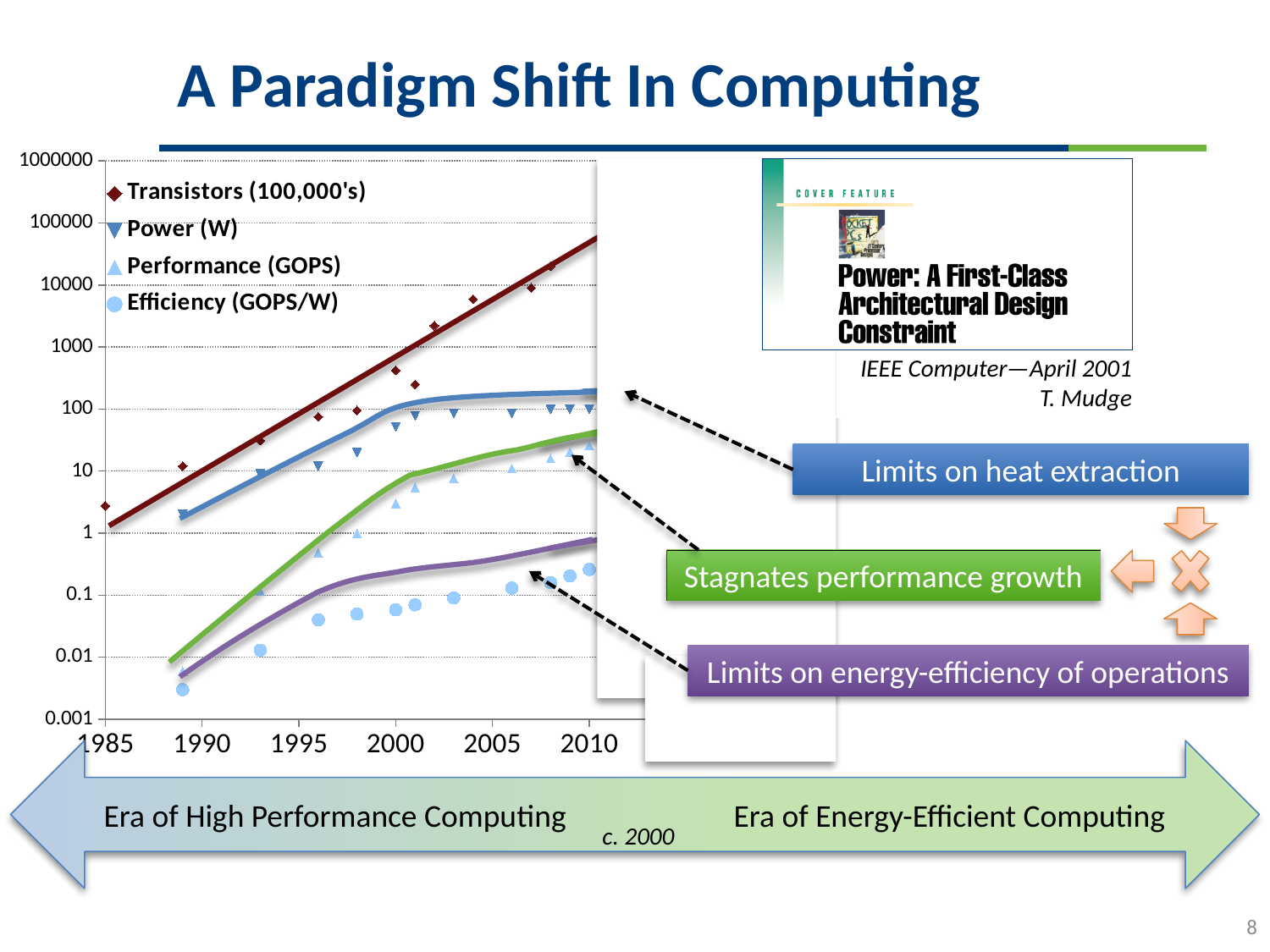
How many series does the chart legend list? 4 Is the Efficiency (GOPS/W) value around 1990 greater or less than 0.01? less Which series has the lowest values around 2010? Efficiency (GOPS/W) Do the Transistors (100,000's) values rise or fall from 1985 to 2010? rise How many year labels are shown along the chart's x axis? 6 Do the Efficiency (GOPS/W) values rise or fall from 1990 to 2010? rise What is the highest value shown on the chart's y axis? 1000000 Which series has the highest values around 2010? Transistors (100,000's) Is the Transistors (100,000's) value around 2004 greater or less than 1000? greater Around 2000, which is larger: the Power (W) value or the Performance (GOPS) value? Power (W) What kind of chart is shown on the slide? scatter chart Which series is listed first in the chart legend? Transistors (100,000's)